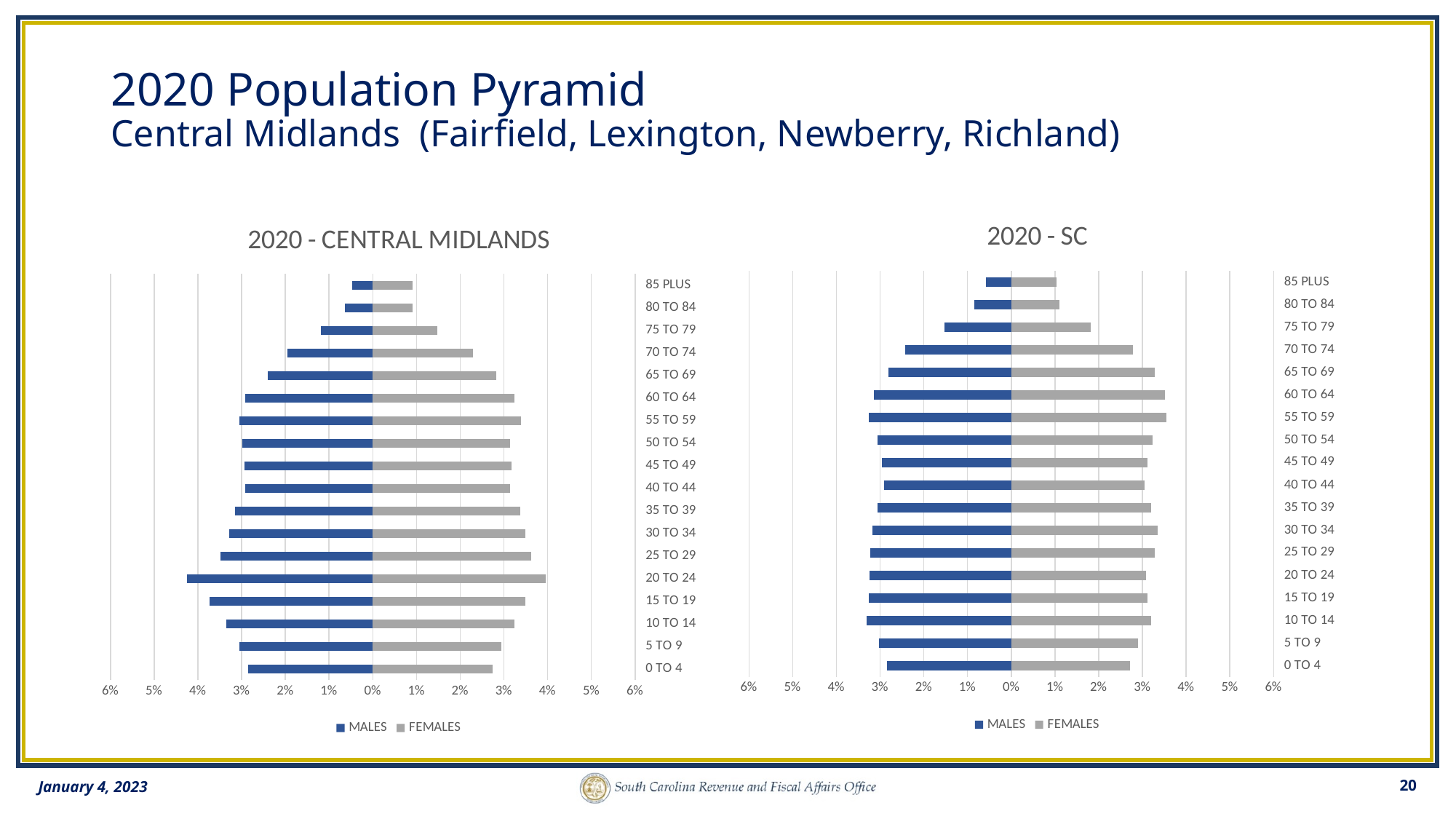
In the 2020 - CENTRAL MIDLANDS chart, which is larger for the 85 PLUS age group: MALES or FEMALES? FEMALES In the 2020 - CENTRAL MIDLANDS chart, is the MALES value for 20 TO 24 greater or less than 4%? greater What kind of chart is the 2020 - CENTRAL MIDLANDS chart? bar chart How many series does the legend of the 2020 - CENTRAL MIDLANDS chart list? 2 Which is larger: the MALES value for 20 TO 24 in the 2020 - CENTRAL MIDLANDS chart or the MALES value for 20 TO 24 in the 2020 - SC chart? 2020 - CENTRAL MIDLANDS In the 2020 - SC chart, what colour are the MALES bars? blue In the 2020 - CENTRAL MIDLANDS chart, which age group has the longest FEMALES bar? 20 TO 24 In the 2020 - CENTRAL MIDLANDS chart, is the MALES value for 85 PLUS greater or less than 1%? less In the 2020 - SC chart, is the FEMALES value for 70 TO 74 greater or less than 3%? less In the 2020 - CENTRAL MIDLANDS chart, which age group has the longest MALES bar? 20 TO 24 How many age groups are shown on the 2020 - SC chart? 18